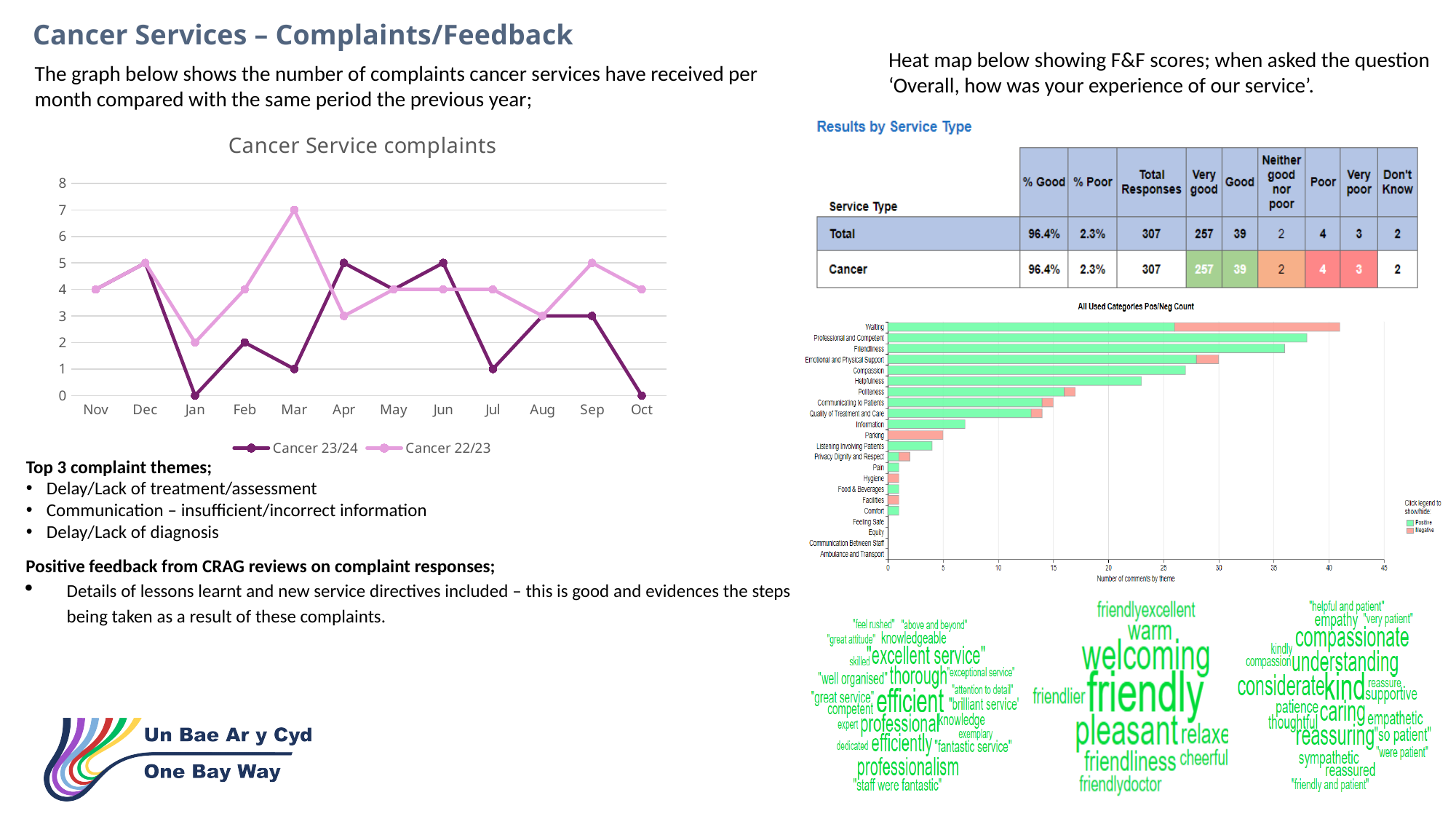
In the Cancer Service complaints chart, how many months are shown on the x axis? 12 In the Cancer Service complaints chart, what kind of chart is it? line chart In the Cancer Service complaints chart, what is the value for Cancer 23/24 in Jan? 0 In the Cancer Service complaints chart, what is the difference between Cancer 22/23 and Cancer 23/24 in Mar? 6 In the Cancer Service complaints chart, what is the value for Cancer 22/23 in Mar? 7 In the Cancer Service complaints chart, which month has the highest value for Cancer 22/23? Mar In the Cancer Service complaints chart, does the Cancer 23/24 series rise or fall from Sep to Oct? fall In the Cancer Service complaints chart, what is the value for Cancer 23/24 in Oct? 0 In the Cancer Service complaints chart, which series has the larger value in Apr, Cancer 23/24 or Cancer 22/23? Cancer 23/24 In the Cancer Service complaints chart, what is the value for Cancer 22/23 in Sep? 5 In the Cancer Service complaints chart, how many series does the legend list? 2 In the All Used Categories Pos/Neg Count chart, is the total bar length for Professional and Competent greater or less than 35? greater